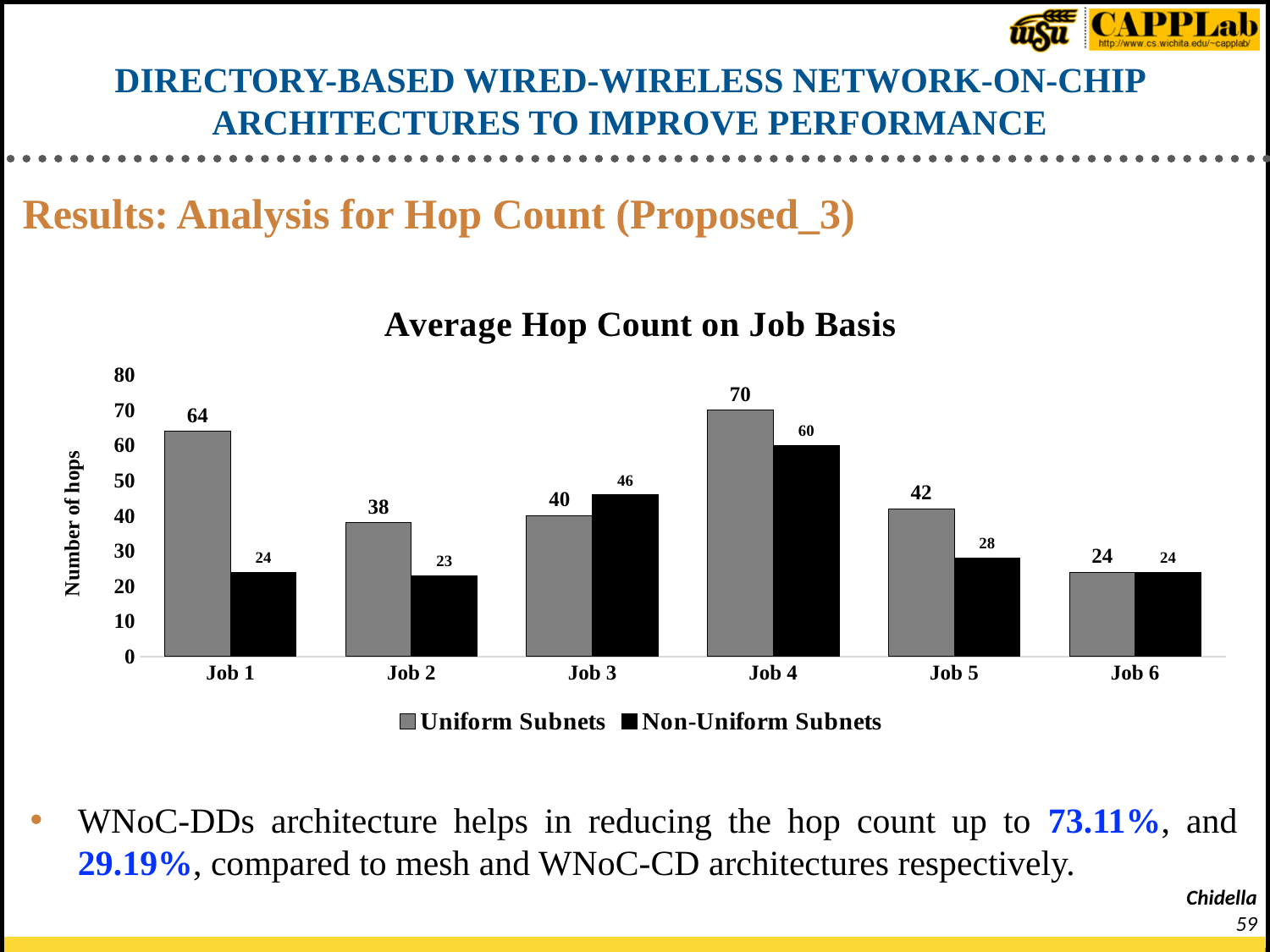
How many series does the legend list? 2 What is the Non-Uniform Subnets value for Job 4? 60 What is the Uniform Subnets value for Job 1? 64 Is the Uniform Subnets value for Job 5 greater or less than 40? greater For Job 3, which series has the larger value, Uniform Subnets or Non-Uniform Subnets? Non-Uniform Subnets What is the difference between the Uniform Subnets and Non-Uniform Subnets values for Job 1? 40 What is the title of the chart? Average Hop Count on Job Basis Which job has the lowest Non-Uniform Subnets value? Job 2 What is the Non-Uniform Subnets value for Job 2? 23 How many jobs are shown on the x axis? 6 What kind of chart is shown? bar chart Which job has the highest Uniform Subnets value? Job 4